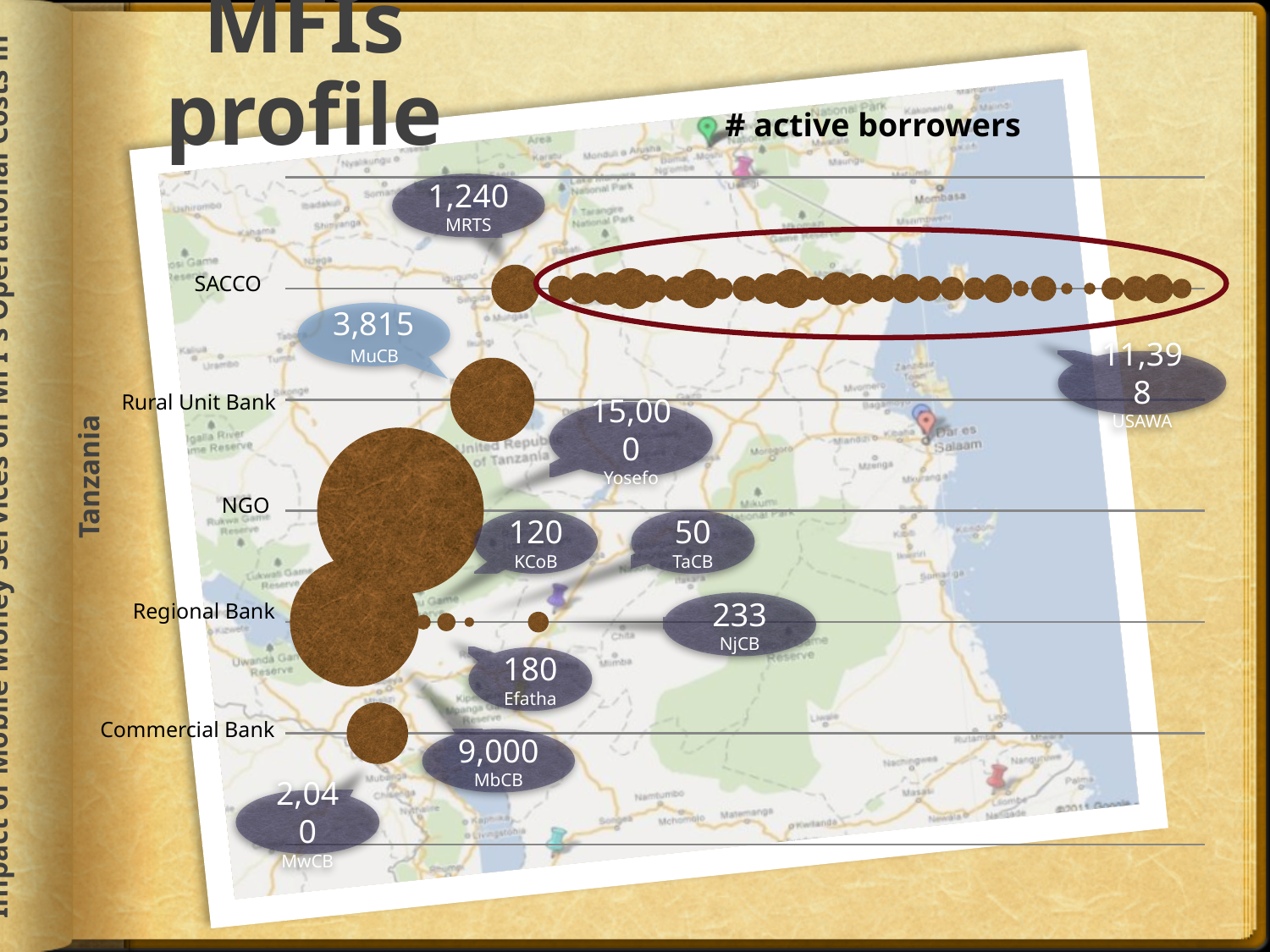
What is the number of active borrowers shown for Yosefo? 15,000 What is the number of active borrowers shown for USAWA? 11,398 Which labelled MFI has the highest number of active borrowers? Yosefo Which labelled MFI has the lowest number of active borrowers? TaCB How many MFI categories are listed along the vertical axis? 5 What is the difference in active borrowers between Yosefo and USAWA? 3,602 What is the number of active borrowers shown for MbCB? 9,000 What is the number of active borrowers shown for MRTS? 1,240 Which has more active borrowers, MuCB or MwCB? MuCB What is the number of active borrowers shown for TaCB? 50 What quantity does the chart legend say the bubbles represent? # active borrowers What kind of chart is shown on the slide? Bubble chart